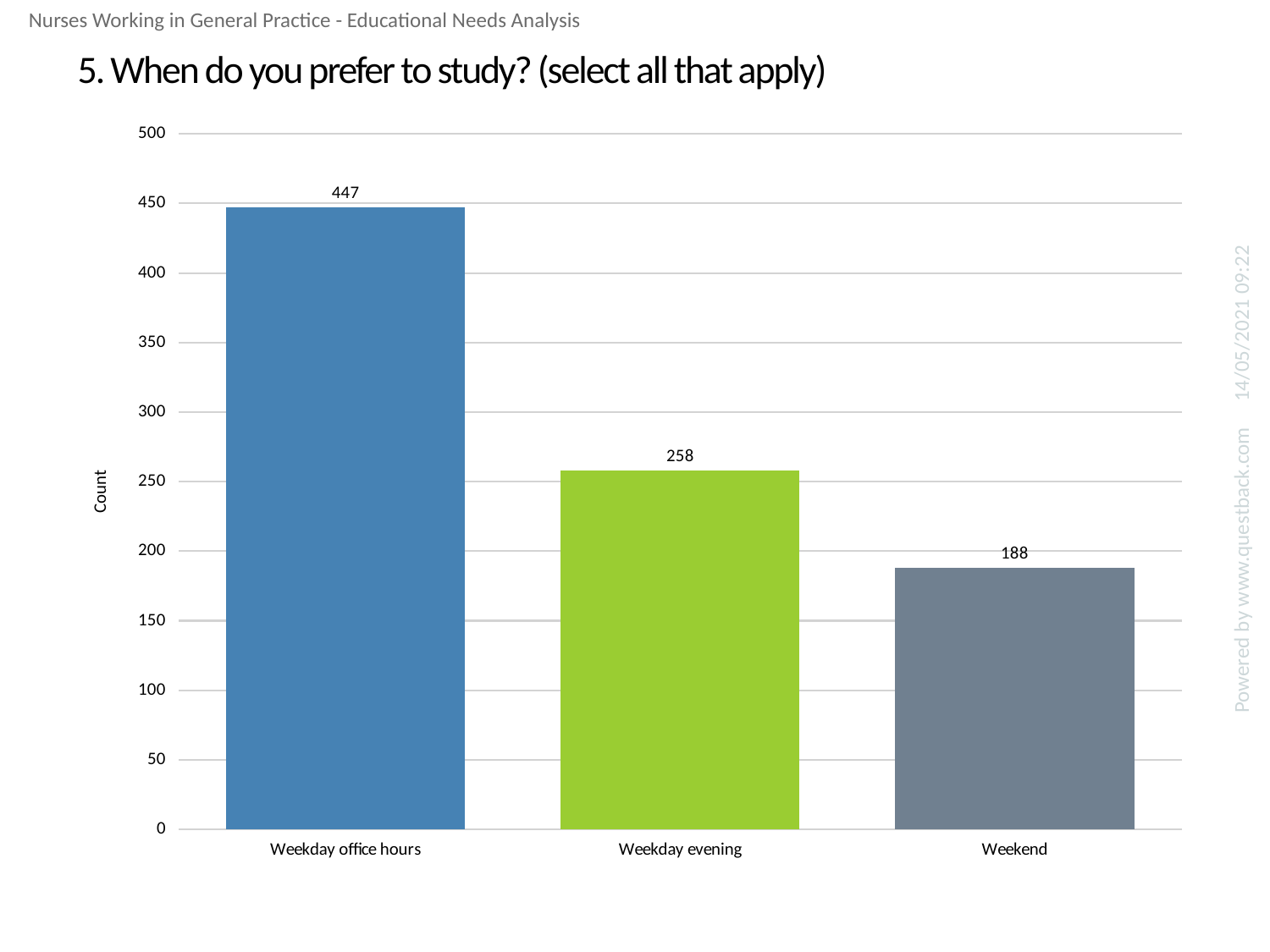
Which study time has the lowest count? Weekend How many categories are shown in the chart? 3 Which study time has the highest count? Weekday office hours What is the difference between the counts for Weekday evening and Weekend? 70 What is the count for Weekday office hours? 447 What kind of chart is shown on the slide? bar chart Is the value for Weekend greater or less than 200? less What is the label on the vertical axis of the chart? Count What is the count for Weekend? 188 What is the difference between the counts for Weekday office hours and Weekday evening? 189 What is the count for Weekday evening? 258 Which has a larger count, Weekday evening or Weekend? Weekday evening